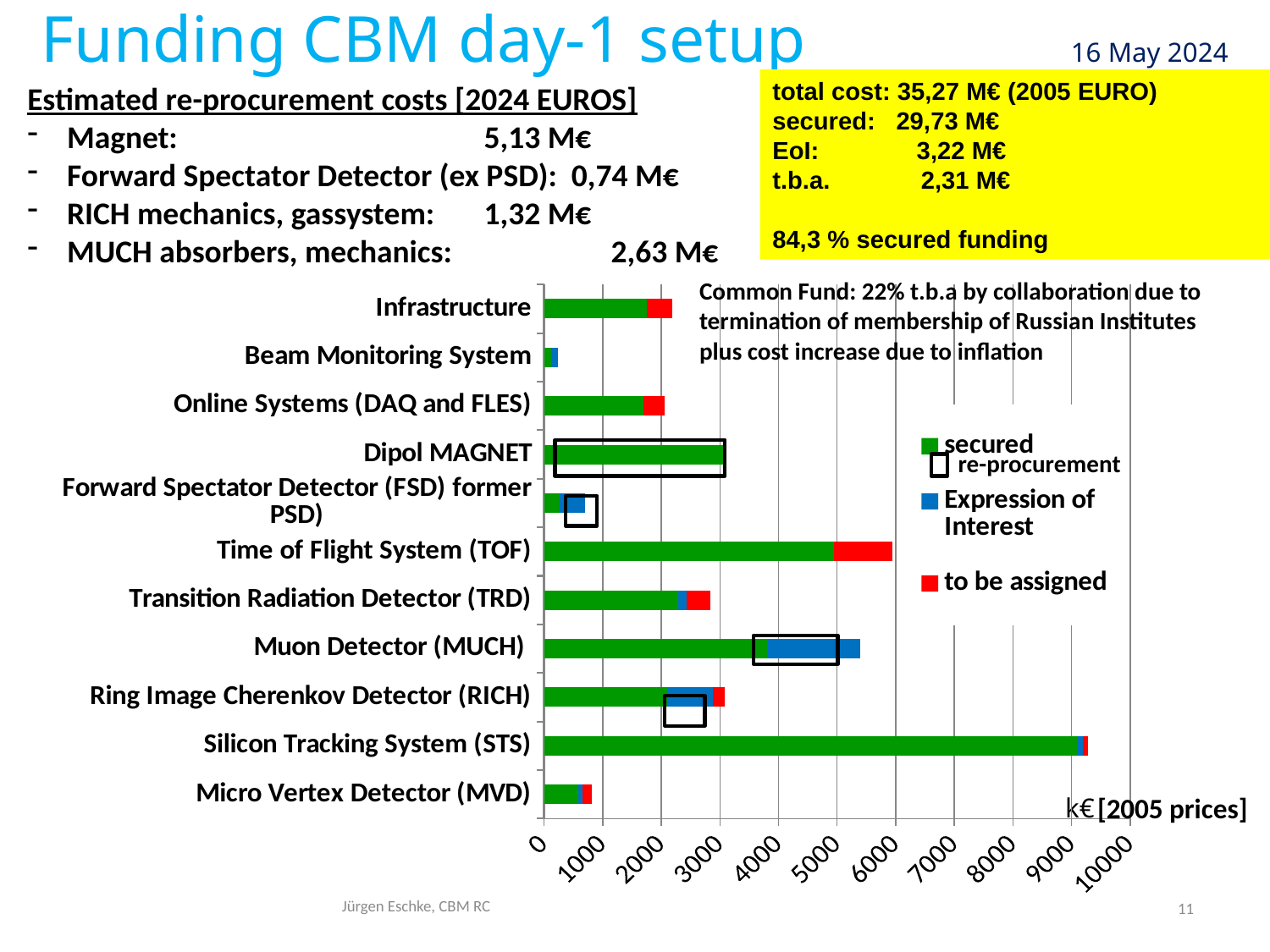
Is the total bar length for Muon Detector (MUCH) greater or less than 4000? greater Which has the longer bar: Time of Flight System (TOF) or Transition Radiation Detector (TRD)? Time of Flight System (TOF) How many categories (detector systems) are listed on the chart's vertical axis? 11 Which category has the shortest bar in the chart? Beam Monitoring System Which colour represents 'to be assigned' in the chart legend? red How many entries does the chart's legend list? 4 Which category has the longest bar in the chart? Silicon Tracking System (STS) What kind of chart is shown on the slide? bar chart Is the total bar length for Silicon Tracking System (STS) greater or less than 8000? greater Is the total bar length for Time of Flight System (TOF) greater or less than 5000? greater What unit label is shown on the chart's horizontal axis? k€ [2005 prices]